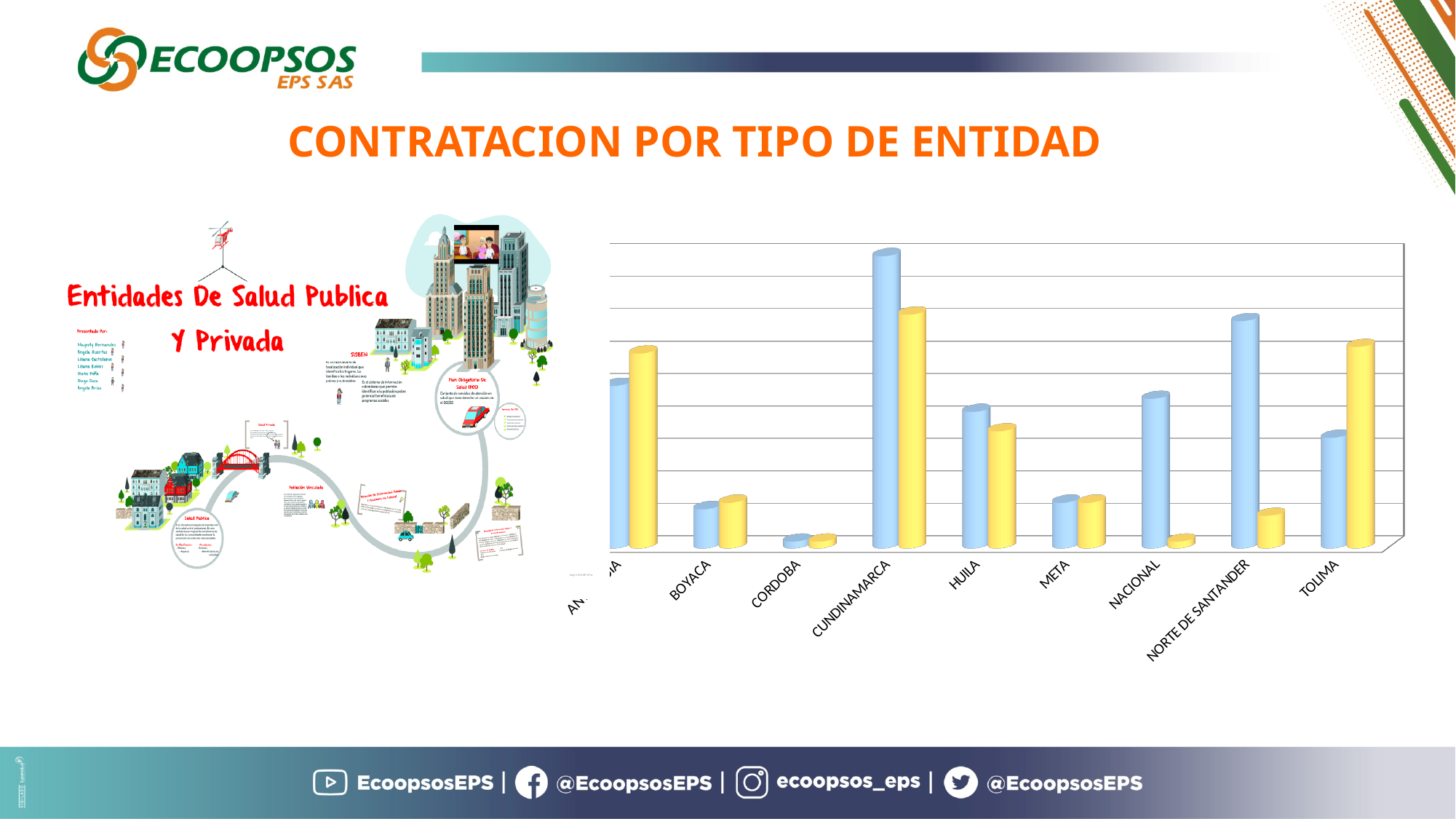
How many bars are plotted for each category in the bar chart? 2 For NORTE DE SANTANDER, which bar is taller, the blue one or the yellow one? Blue What is the title shown above the chart on the slide? CONTRATACION POR TIPO DE ENTIDAD For NACIONAL, which bar is taller, the blue one or the yellow one? Blue What kind of chart is shown on the right side of the slide? Bar chart Which category has the tallest blue bar in the chart? CUNDINAMARCA For TOLIMA, which bar is taller, the blue one or the yellow one? Yellow Which category has the tallest yellow bar in the chart? CUNDINAMARCA Which category has the shortest blue bar in the chart? CORDOBA Which category has the second tallest blue bar in the chart? NORTE DE SANTANDER How many categories are shown along the x axis of the bar chart? 9